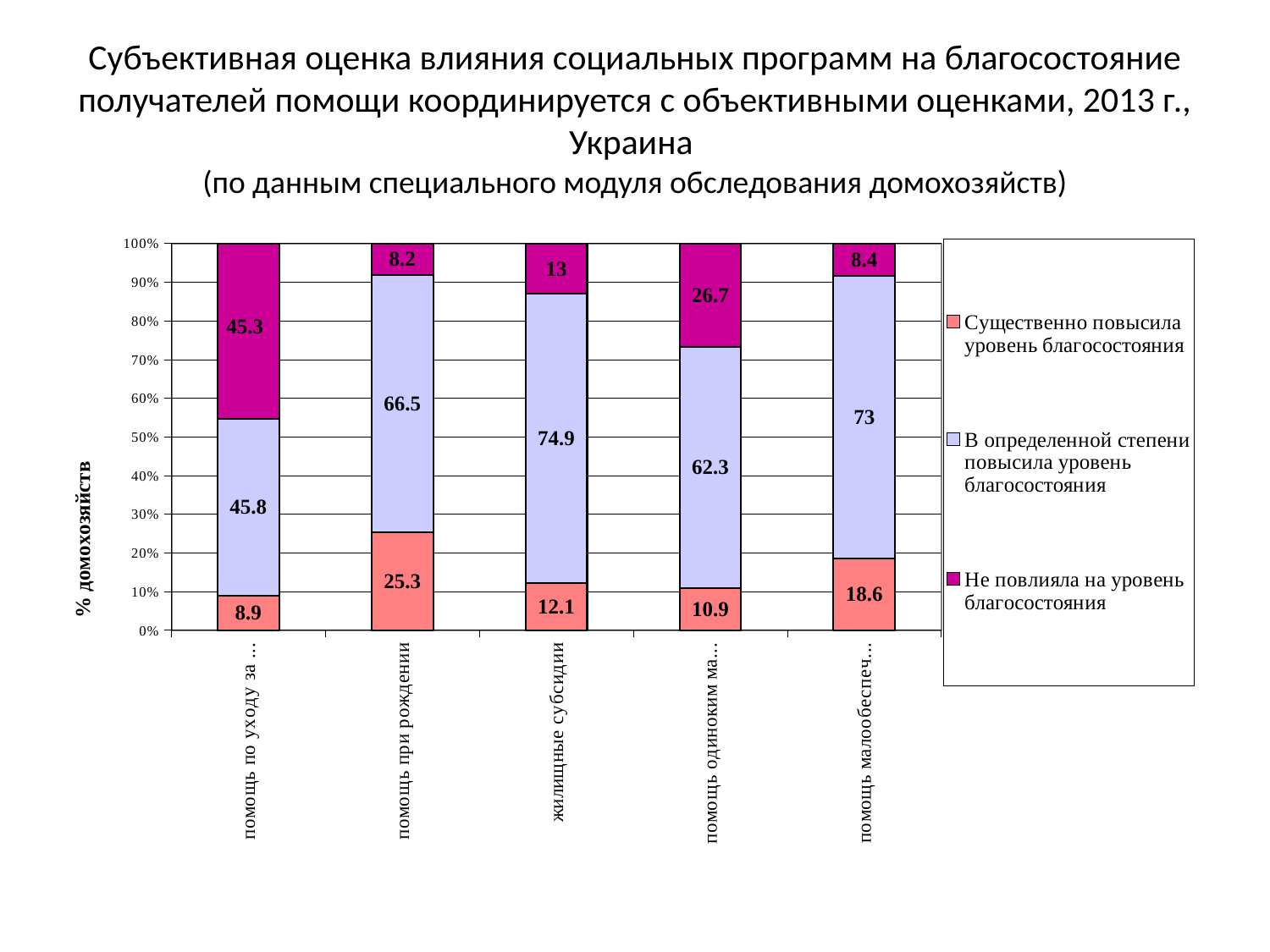
What is the value of the 'Не повлияла на уровень благосостояния' segment in the first (leftmost) bar? 45.3 Which has a larger 'Существенно повысила уровень благосостояния' value: помощь при рождении or жилищные субсидии? помощь при рождении What is the value of the 'В определенной степени повысила уровень благосостояния' segment for жилищные субсидии? 74.9 What is the title of the vertical axis? % домохозяйств For помощь при рождении, what is the difference between the 'В определенной степени повысила' value and the 'Существенно повысила' value? 41.2 Which category has the highest value for 'Существенно повысила уровень благосостояния'? помощь при рождении What is the value of the 'Не повлияла на уровень благосостояния' segment for помощь при рождении? 8.2 What kind of chart is shown on the slide? stacked bar chart What percentage of households receiving помощь при рождении said the program существенно повысила уровень благосостояния? 25.3 How many categories (bars) are shown on the chart? 5 Which category has the highest value for 'В определенной степени повысила уровень благосостояния'? жилищные субсидии How many series does the legend list? 3